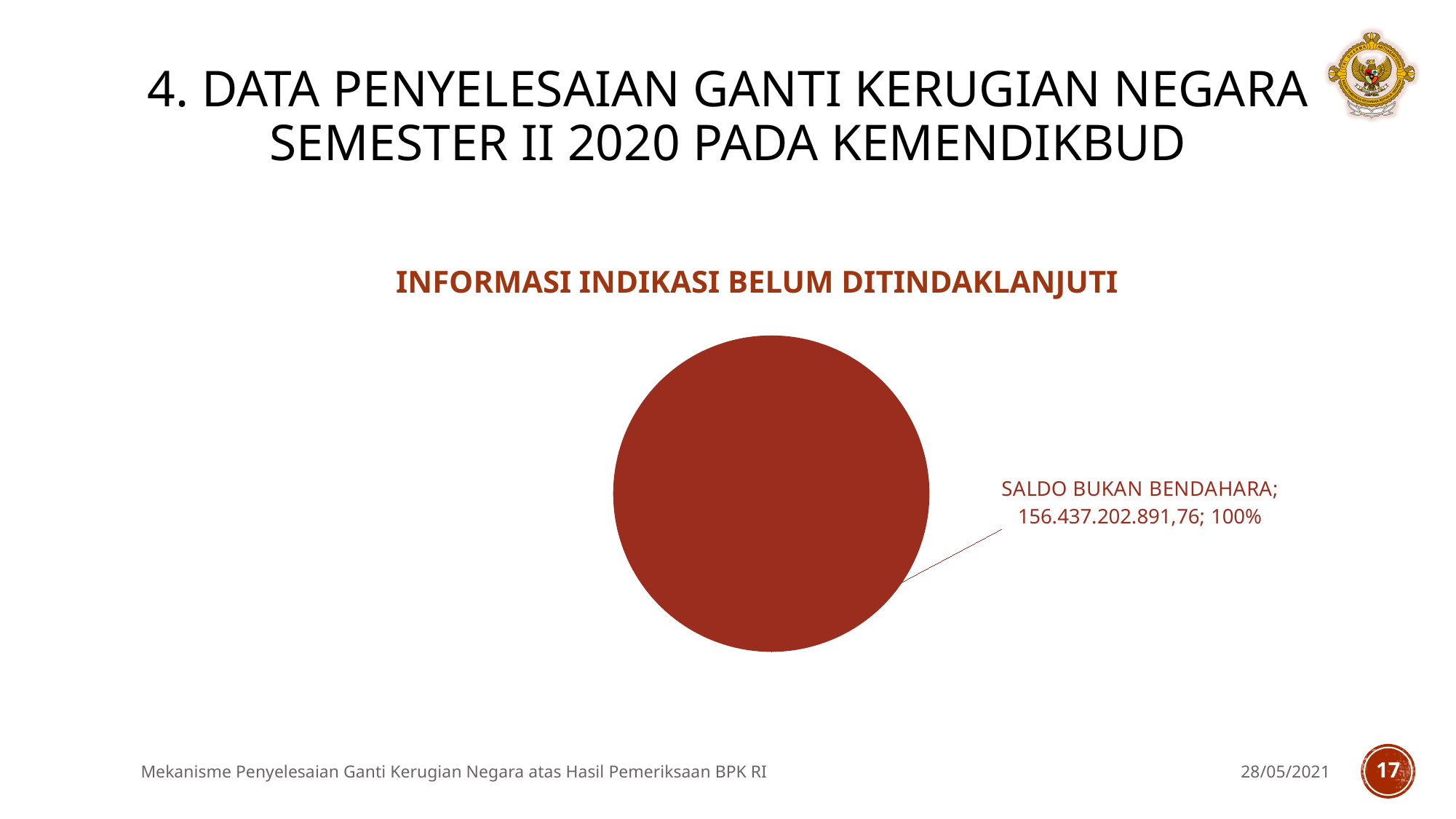
What is the value shown for SALDO BUKAN BENDAHARA? 156.437.202.891,76 Which category is the largest slice of the pie chart? SALDO BUKAN BENDAHARA What is the title of the chart? INFORMASI INDIKASI BELUM DITINDAKLANJUTI What colour is the pie slice for SALDO BUKAN BENDAHARA? Dark red What kind of chart is shown on the slide? Pie chart What share of the pie does SALDO BUKAN BENDAHARA represent? 100% How many slices does the pie chart have? 1